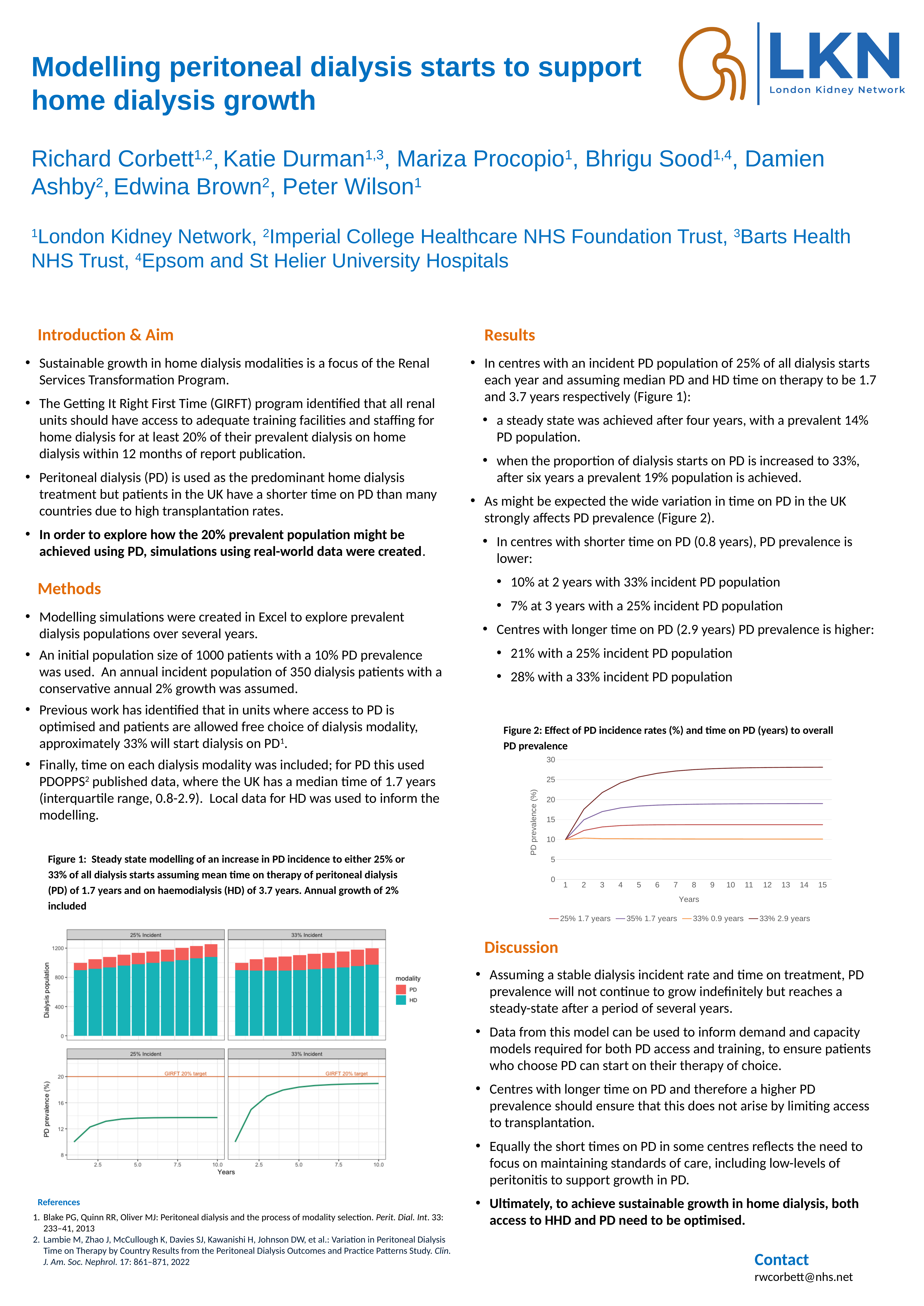
How many years are shown on the x axis of Figure 2? 15 In Figure 2, is the PD prevalence for the 33% 2.9 years series at year 15 greater or less than 25? greater In Figure 2, which series reaches the highest PD prevalence? 33% 2.9 years What kind of chart is the top part of Figure 1 showing dialysis population by modality? bar chart Which two modalities does the legend of the Figure 1 bar chart list? PD and HD In Figure 2, which series has the lowest PD prevalence at year 15? 33% 0.9 years How many series does the legend of Figure 2 list? 4 In the Figure 1 PD prevalence panel for 33% Incident, is the PD prevalence at 10 years greater or less than the 20% GIRFT target line? less What is the label of the x axis in Figure 2? Years In Figure 2, is the PD prevalence for the 25% 1.7 years series at year 15 greater or less than 15? less What kind of chart is Figure 2 (Effect of PD incidence rates and time on PD to overall PD prevalence)? line chart In Figure 2, which series has the higher PD prevalence at year 10: 35% 1.7 years or 25% 1.7 years? 35% 1.7 years